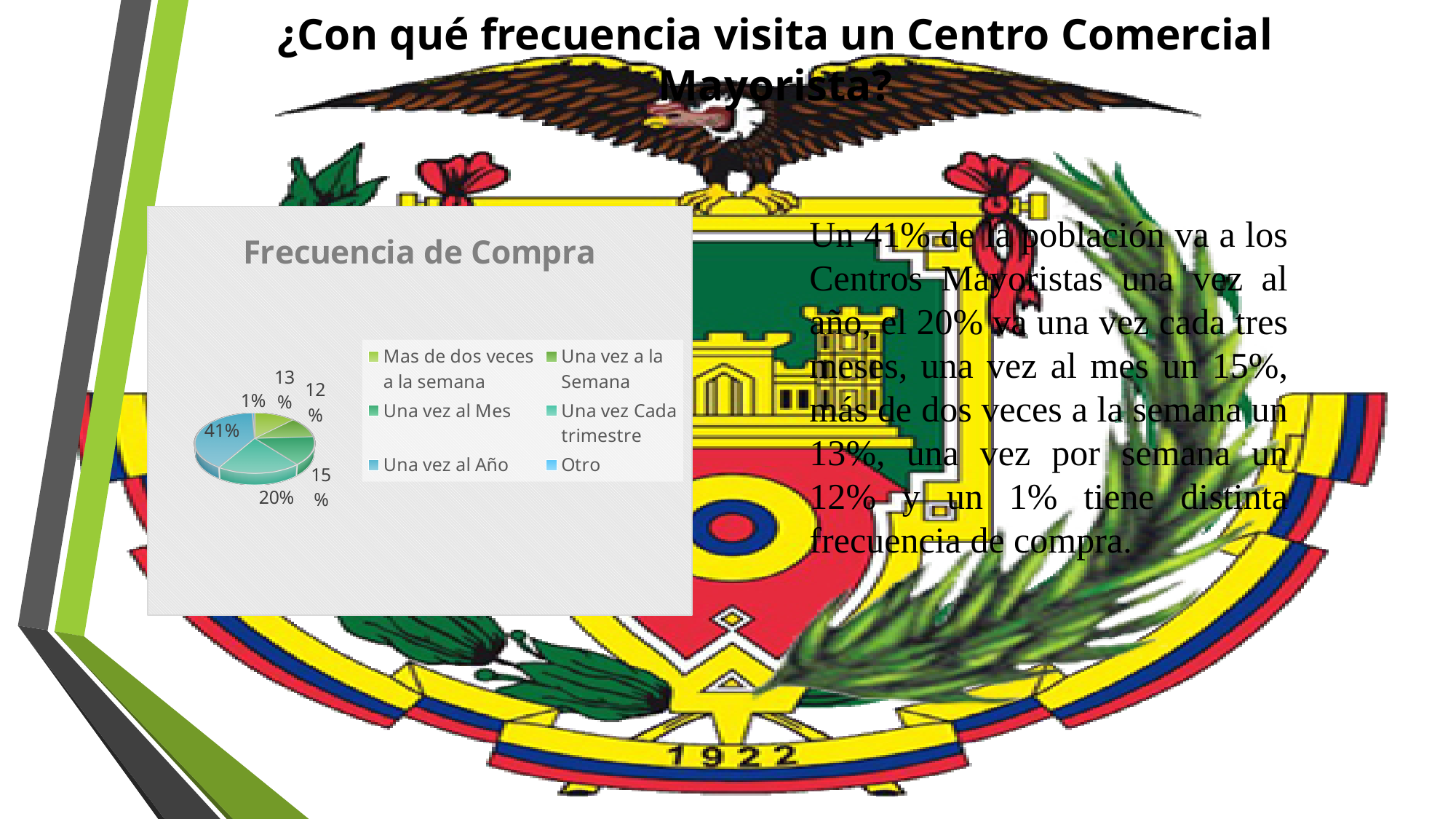
How many categories does the chart's legend list? 6 What is the difference in percentage points between "Una vez al Año" and "Una vez Cada trimestre"? 21 What share of the pie corresponds to "Una vez al Año"? 41% What is the title of the chart? Frecuencia de Compra Which is larger, the slice for "Una vez al Mes" or the slice for "Una vez a la Semana"? Una vez al Mes What share of the pie corresponds to "Una vez Cada trimestre"? 20% What share of the pie corresponds to "Mas de dos veces a la semana"? 13% What kind of chart is shown on the slide? pie chart Which category has the smallest slice of the pie? Otro Which category has the largest slice of the pie? Una vez al Año